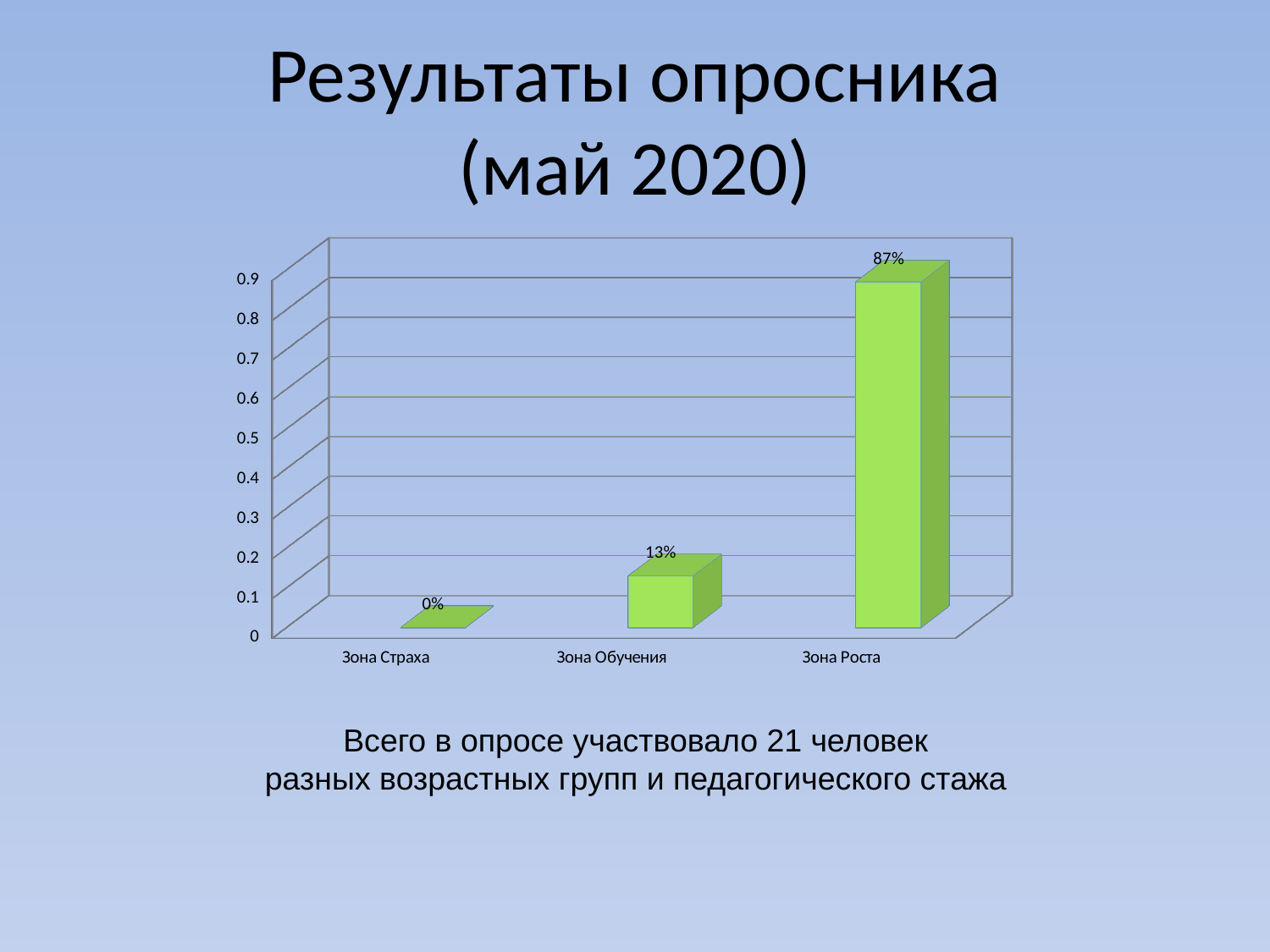
What is the value for Зона Страха? 0% What is the difference between the values for Зона Роста and Зона Обучения? 74% What colour are the bars in the chart? green Which category has the lowest value? Зона Страха What kind of chart is shown on the slide? bar chart Which is larger, the value for Зона Обучения or the value for Зона Страха? Зона Обучения How many categories are shown on the x axis? 3 What is the value for Зона Обучения? 13% What is the value for Зона Роста? 87% Which category has the highest value? Зона Роста Do the values rise or fall from left to right along the x axis? rise Is the value for Зона Роста greater or less than 0.5? greater